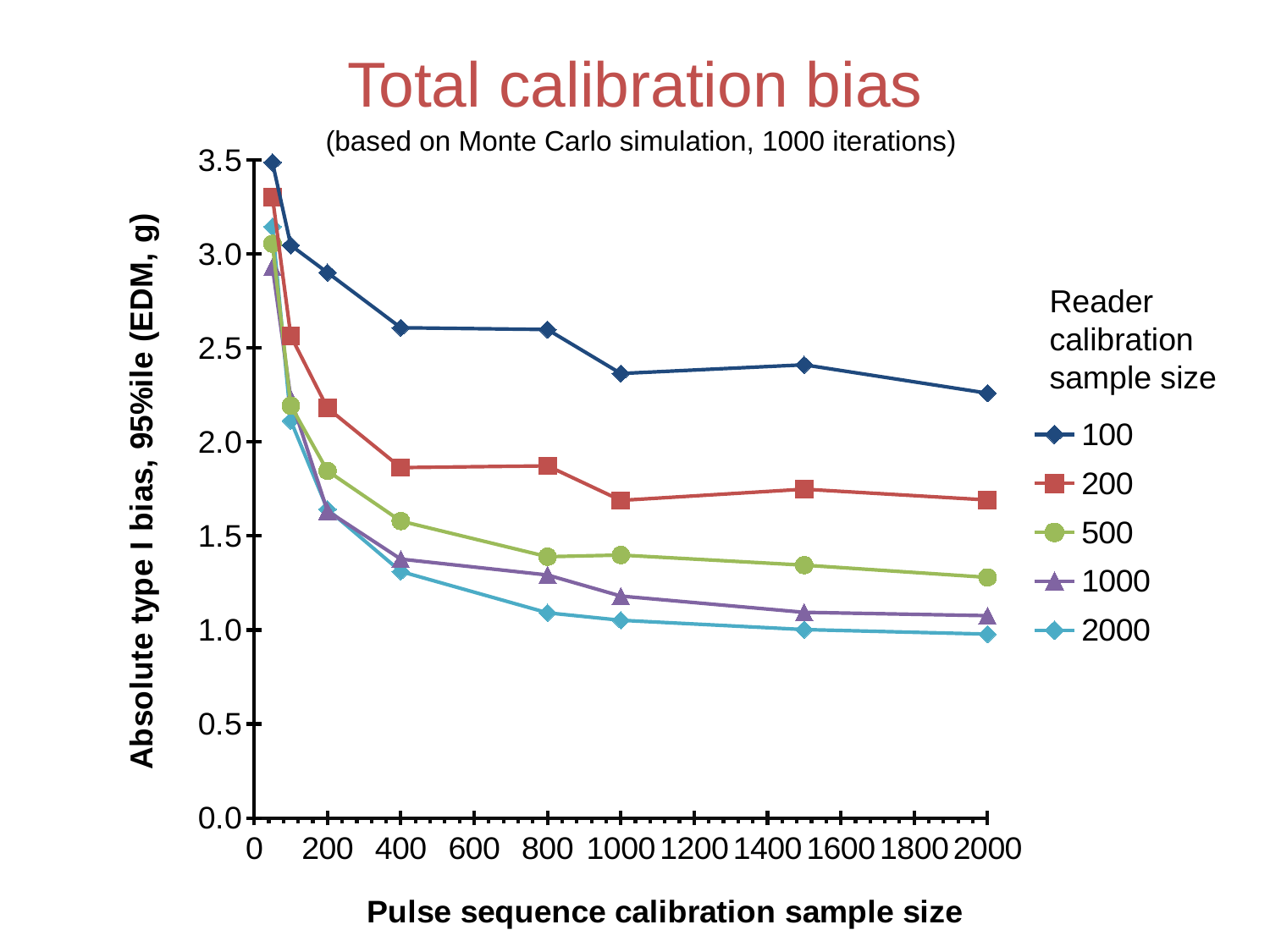
Does the bias for the reader calibration sample size 100 series rise or fall as the pulse sequence calibration sample size increases? fall How many data points are plotted for the 100 series? 8 What is the label of the x axis? Pulse sequence calibration sample size At a pulse sequence calibration sample size of 2000, which has the larger bias: the 100 series or the 200 series? 100 Which reader calibration sample size series has the highest bias at a pulse sequence calibration sample size of 1000? 100 Which reader calibration sample size series has the lowest bias at a pulse sequence calibration sample size of 1000? 2000 Is the value for the 100 series at a pulse sequence calibration sample size of 2000 greater or less than 2.0? greater Is the value for the 2000 series at a pulse sequence calibration sample size of 2000 greater or less than 1.5? less What kind of chart is shown on the slide? line chart What is the title of the chart? Total calibration bias Is the value for the 200 series at a pulse sequence calibration sample size of 400 greater or less than 1.5? greater How many series does the legend list? 5